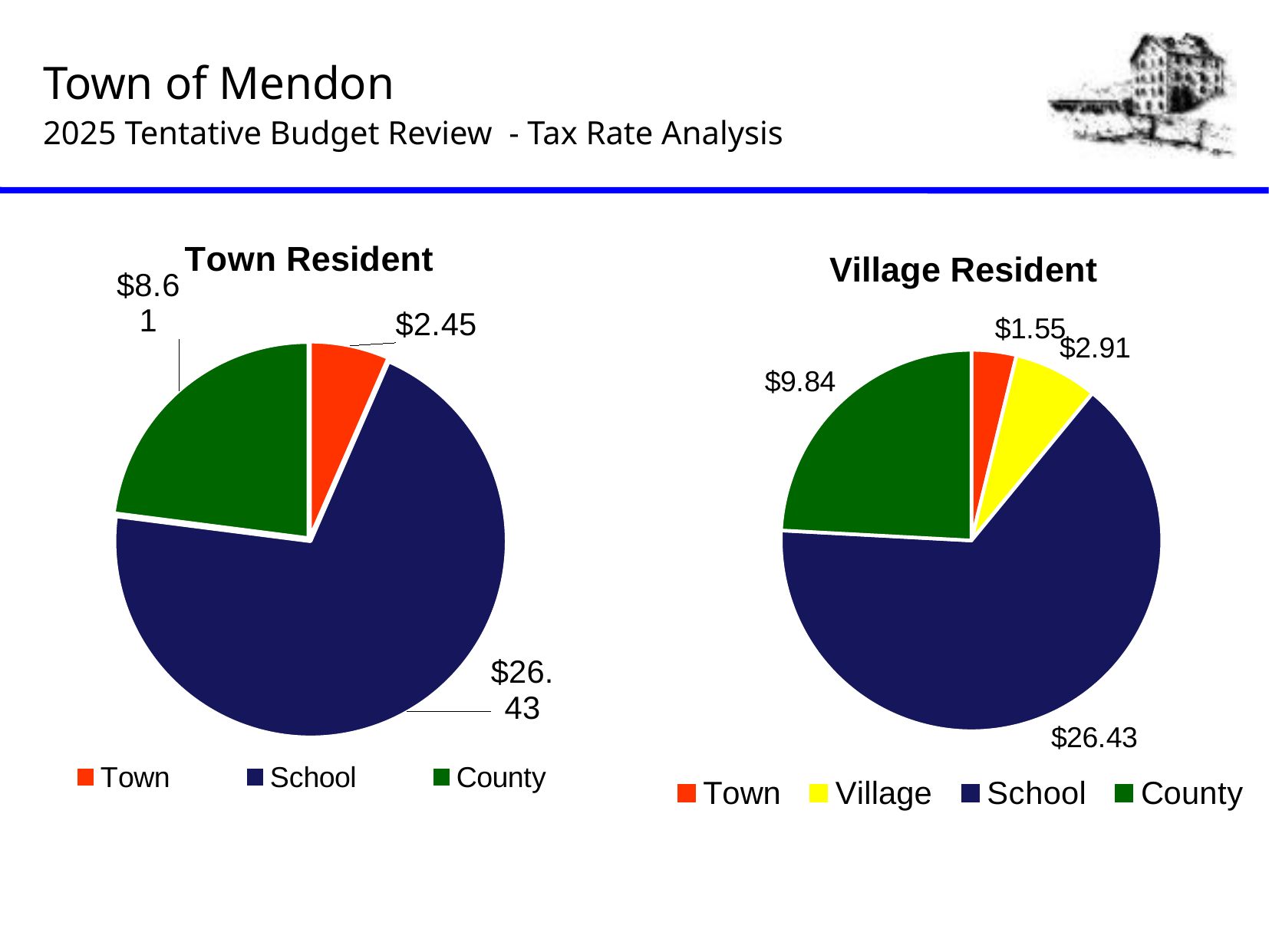
In the Village Resident chart, what is the value for Town? $1.55 In the Town Resident chart, which category has the largest slice? School In the Village Resident chart, which category has the smallest slice? Town How many entries does the legend of the Town Resident chart list? 3 In the Village Resident chart, what is the value for Village? $2.91 In the Town Resident chart, what is the value for County? $8.61 In the Town Resident chart, what is the difference between the County value and the Town value? $6.16 In the Village Resident chart, which is larger, County or Village? County How many categories does the Village Resident chart show? 4 In the Village Resident chart, what colour is the Village slice? Yellow In the Town Resident chart, what is the value for School? $26.43 What kind of chart is the Village Resident chart? Pie chart